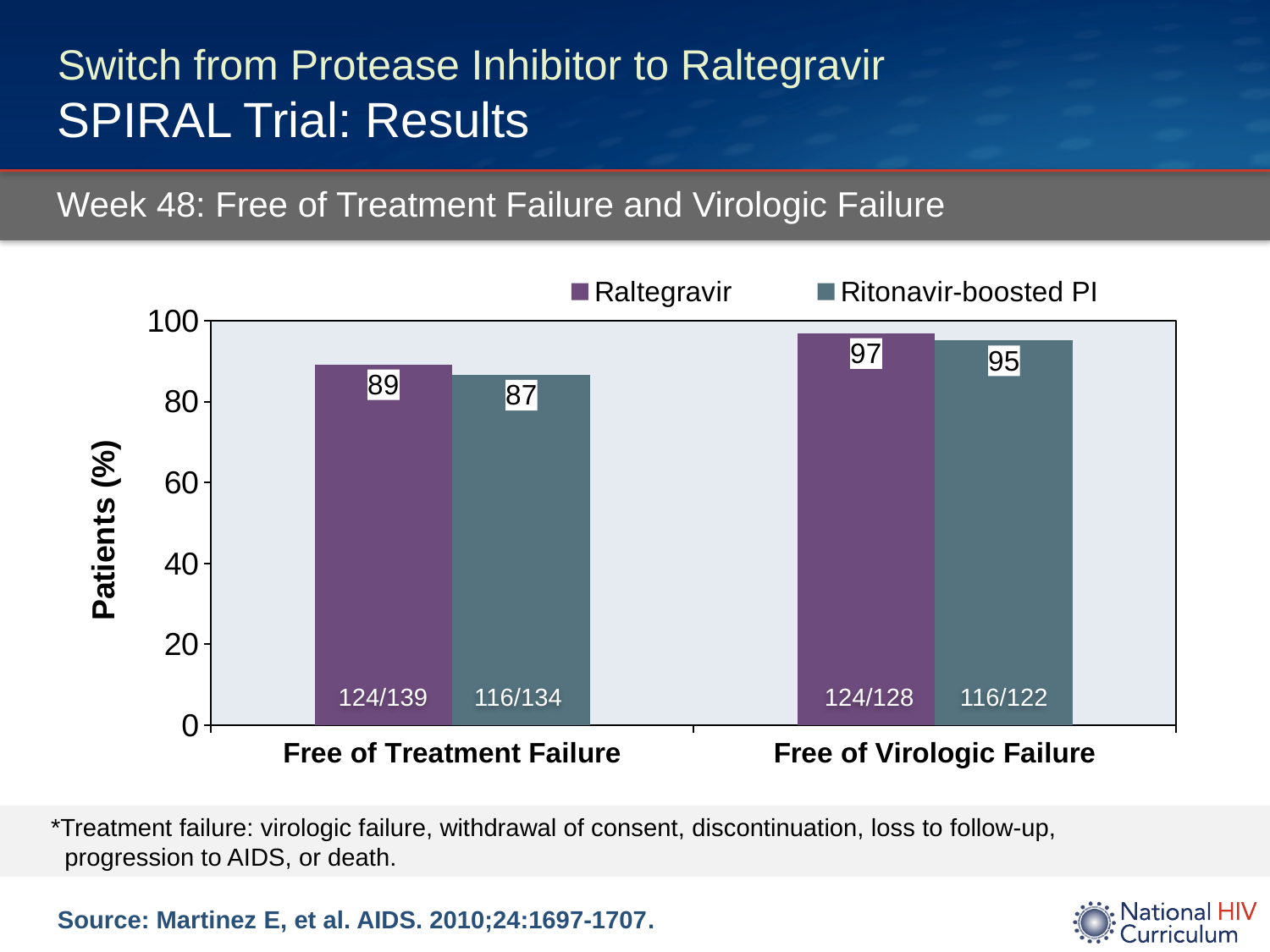
Which bar shows the lowest value on the chart? Ritonavir-boosted PI, Free of Treatment Failure What is the label of the y axis? Patients (%) What percentage of Ritonavir-boosted PI patients were free of treatment failure? 87 What percentage of Raltegravir patients were free of treatment failure? 89 For Free of Treatment Failure, which series has the larger value, Raltegravir or Ritonavir-boosted PI? Raltegravir What is the difference between the Raltegravir and Ritonavir-boosted PI values for Free of Virologic Failure? 2 What kind of chart is shown on the slide? Bar chart How many series does the legend list? 2 What fraction of patients is shown inside the Raltegravir bar for Free of Virologic Failure? 124/128 Which bar shows the highest value on the chart? Raltegravir, Free of Virologic Failure What percentage of Ritonavir-boosted PI patients were free of virologic failure? 95 How many categories are shown on the x axis? 2